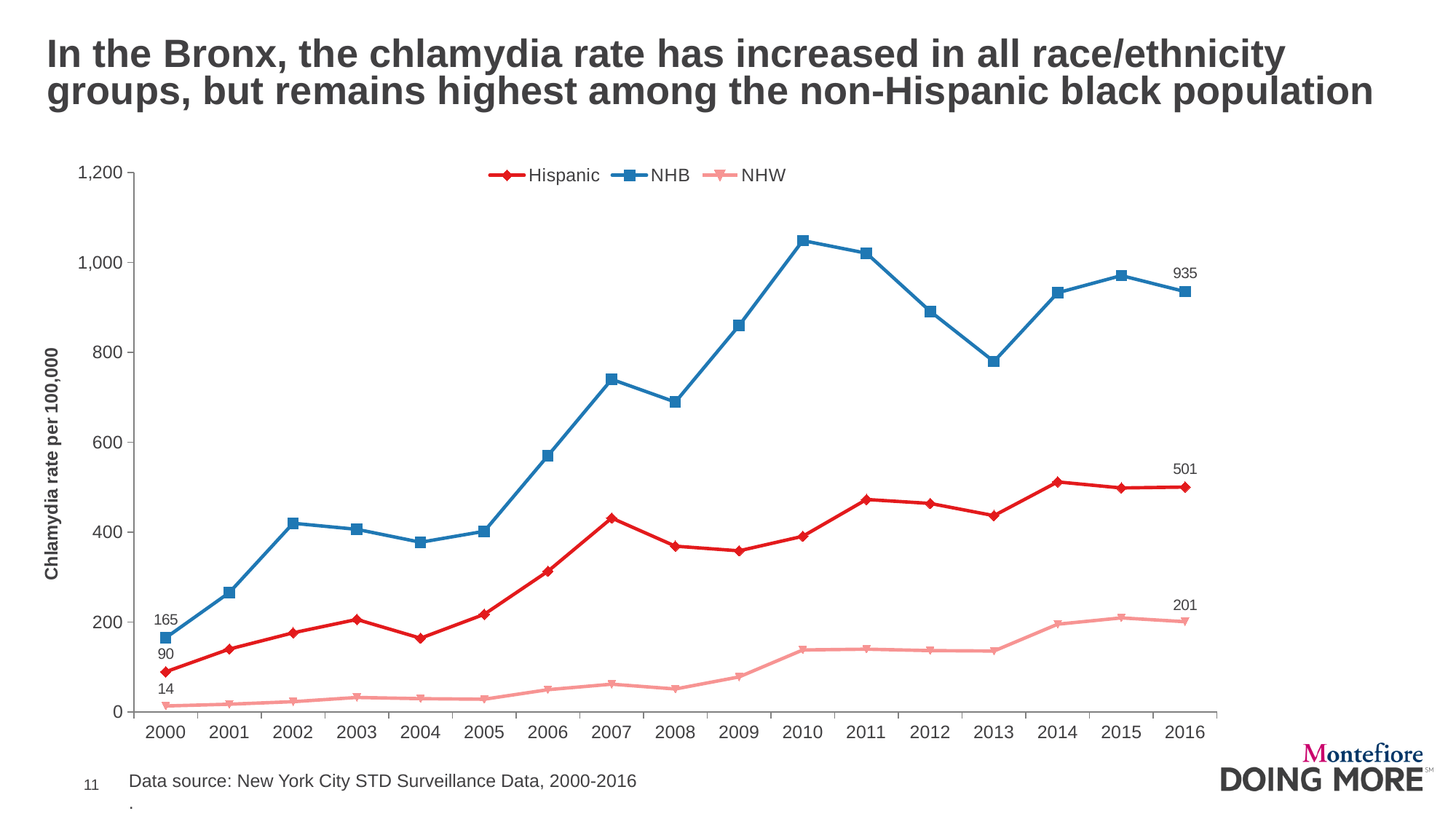
What is the chlamydia rate for Hispanic in 2000? 90 Which series has the lowest chlamydia rate in 2000? NHW What is the difference between the Hispanic and NHW chlamydia rates in 2016? 300 What is the label of the y axis? Chlamydia rate per 100,000 By how much did the NHB chlamydia rate increase from 2000 to 2016? 770 What kind of chart is shown on the slide? Line chart What is the chlamydia rate for NHW in 2016? 201 What is the chlamydia rate for NHB in 2016? 935 What is the chlamydia rate for NHB in 2000? 165 How many series does the legend list? 3 Is the NHB chlamydia rate in 2010 greater or less than 1,000? greater Which series has the highest chlamydia rate in 2016? NHB